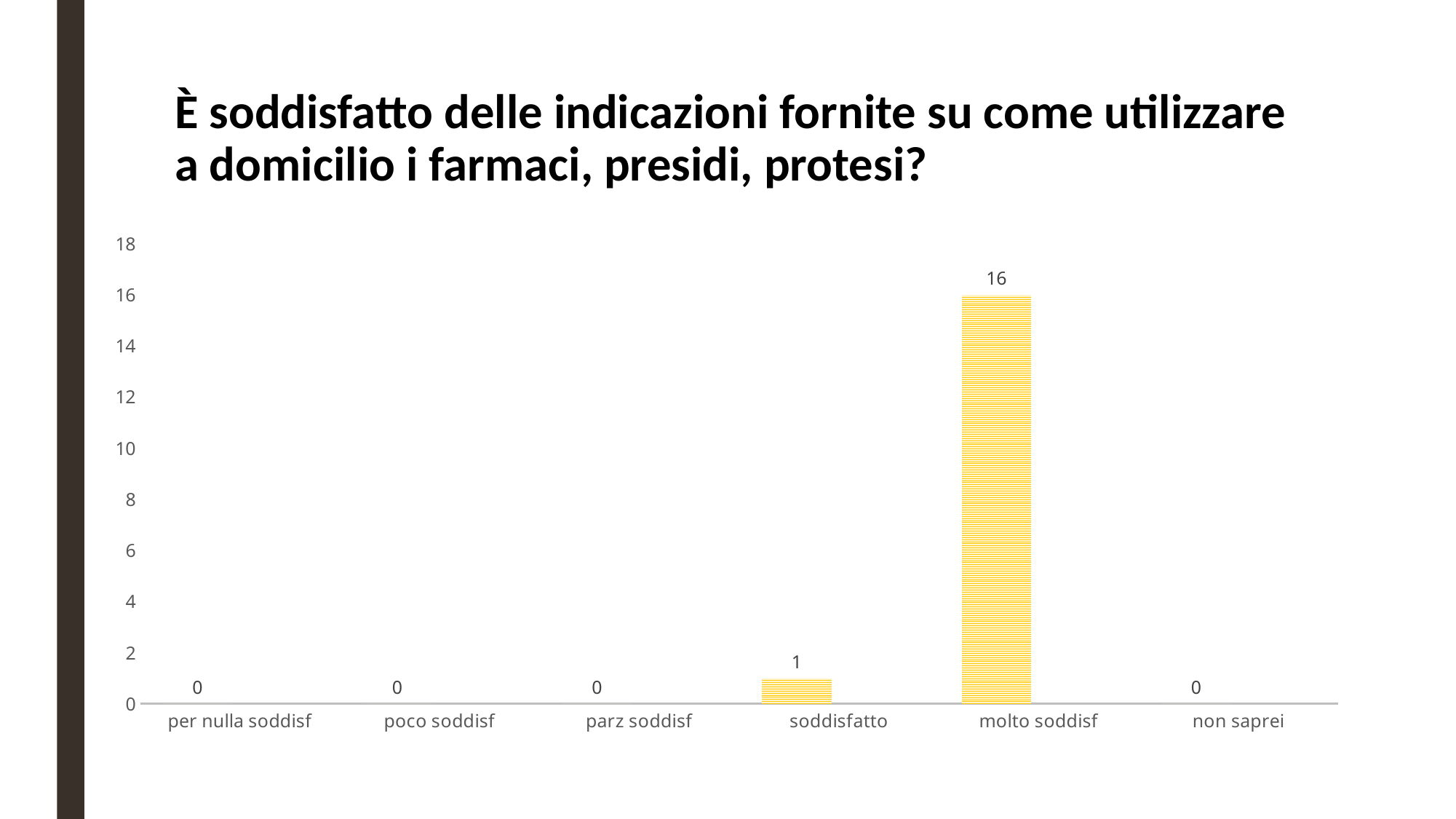
What is the highest value shown on the y axis? 18 What is the value for "non saprei"? 0 What is the value for "soddisfatto"? 1 Is the value for "molto soddisf" greater or less than 10? greater How many categories have a value of 0? 4 Which category has the highest value? molto soddisf Which is larger, the value for "soddisfatto" or the value for "molto soddisf"? molto soddisf What is the difference between the values for "molto soddisf" and "soddisfatto"? 15 What kind of chart is shown on the slide? bar chart What is the value for "molto soddisf"? 16 How many categories are shown on the x axis? 6 What is the value for "per nulla soddisf"? 0